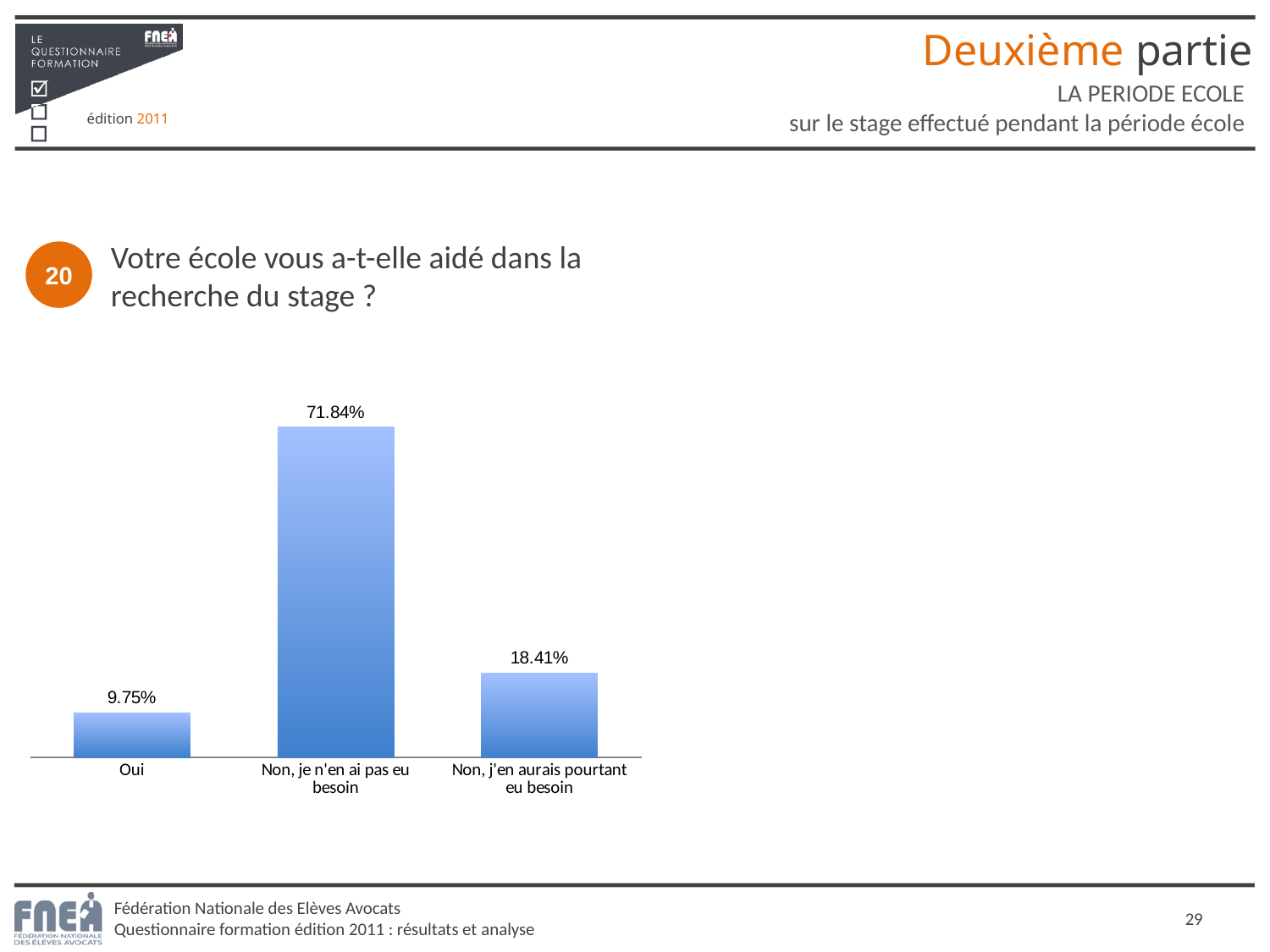
What kind of chart is shown on the slide? Bar chart Which category has the highest value? Non, je n'en ai pas eu besoin What is the difference between the values for "Non, j'en aurais pourtant eu besoin" and "Oui"? 8.66% Which is larger, the value for "Oui" or the value for "Non, j'en aurais pourtant eu besoin"? Non, j'en aurais pourtant eu besoin What is the value for "Non, je n'en ai pas eu besoin"? 71.84% What is the total of the three values shown in the chart? 100% What is the value for "Oui"? 9.75% What is the value for "Non, j'en aurais pourtant eu besoin"? 18.41% How many categories are shown in the chart? 3 Which category has the lowest value? Oui What question does the chart on the slide answer? Votre école vous a-t-elle aidé dans la recherche du stage ? What is the difference between the values for "Non, je n'en ai pas eu besoin" and "Non, j'en aurais pourtant eu besoin"? 53.43%